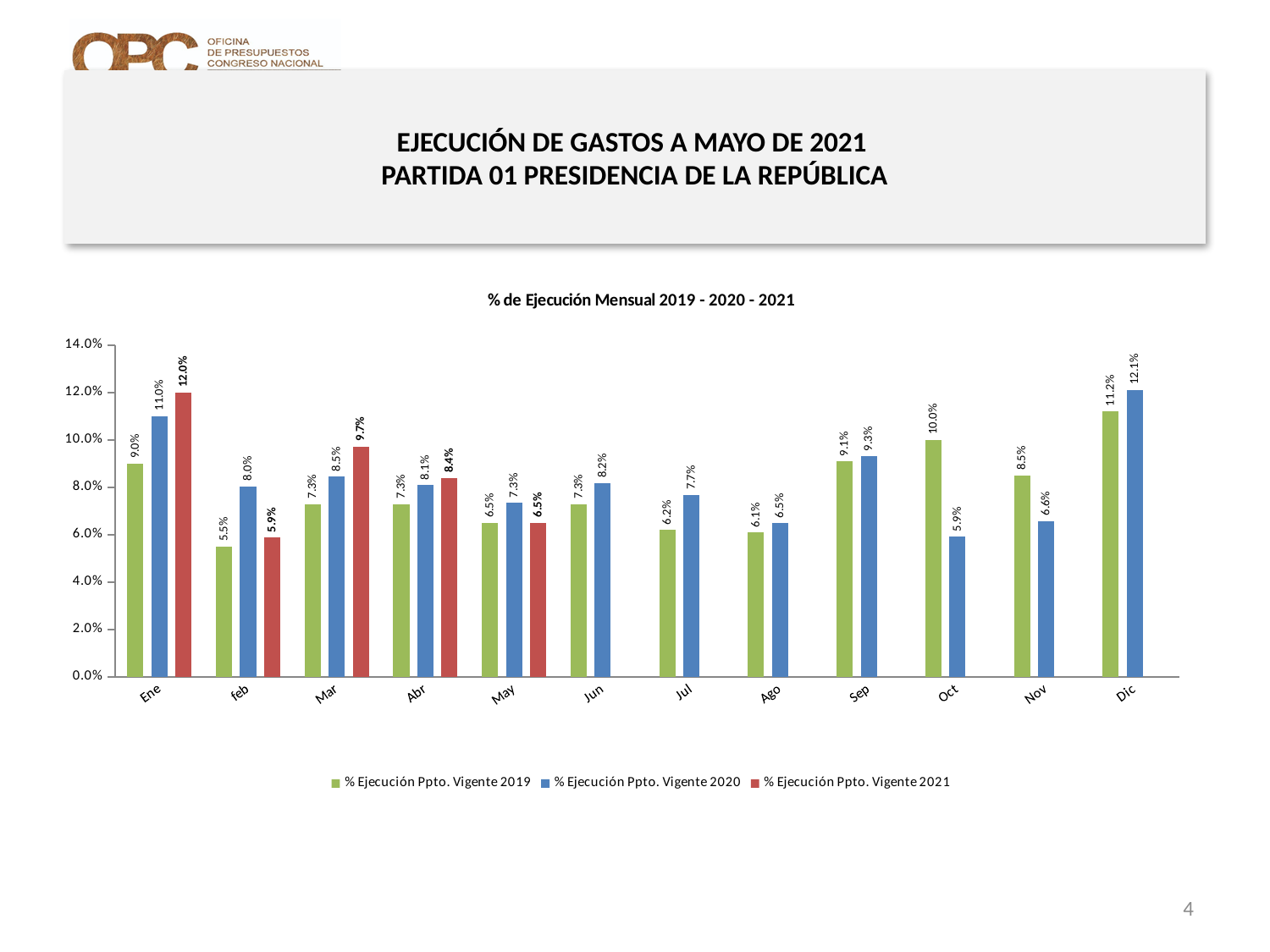
What is the title of the chart? % de Ejecución Mensual 2019 - 2020 - 2021 How many months have a value for % Ejecución Ppto. Vigente 2021? 5 How many series does the legend list? 3 What is the value for % Ejecución Ppto. Vigente 2021 in Ene? 12.0% In which month is the % Ejecución Ppto. Vigente 2019 series lowest? feb What is the value for % Ejecución Ppto. Vigente 2019 in Dic? 11.2% What is the difference between the 2021 and 2019 values in Mar? 2.4% In which month is the % Ejecución Ppto. Vigente 2020 series highest? Dic What kind of chart is shown? Bar chart Which is larger in Oct: the 2019 value or the 2020 value? 2019 value (10.0%) How many months are shown on the x axis? 12 What is the value for % Ejecución Ppto. Vigente 2020 in Oct? 5.9%